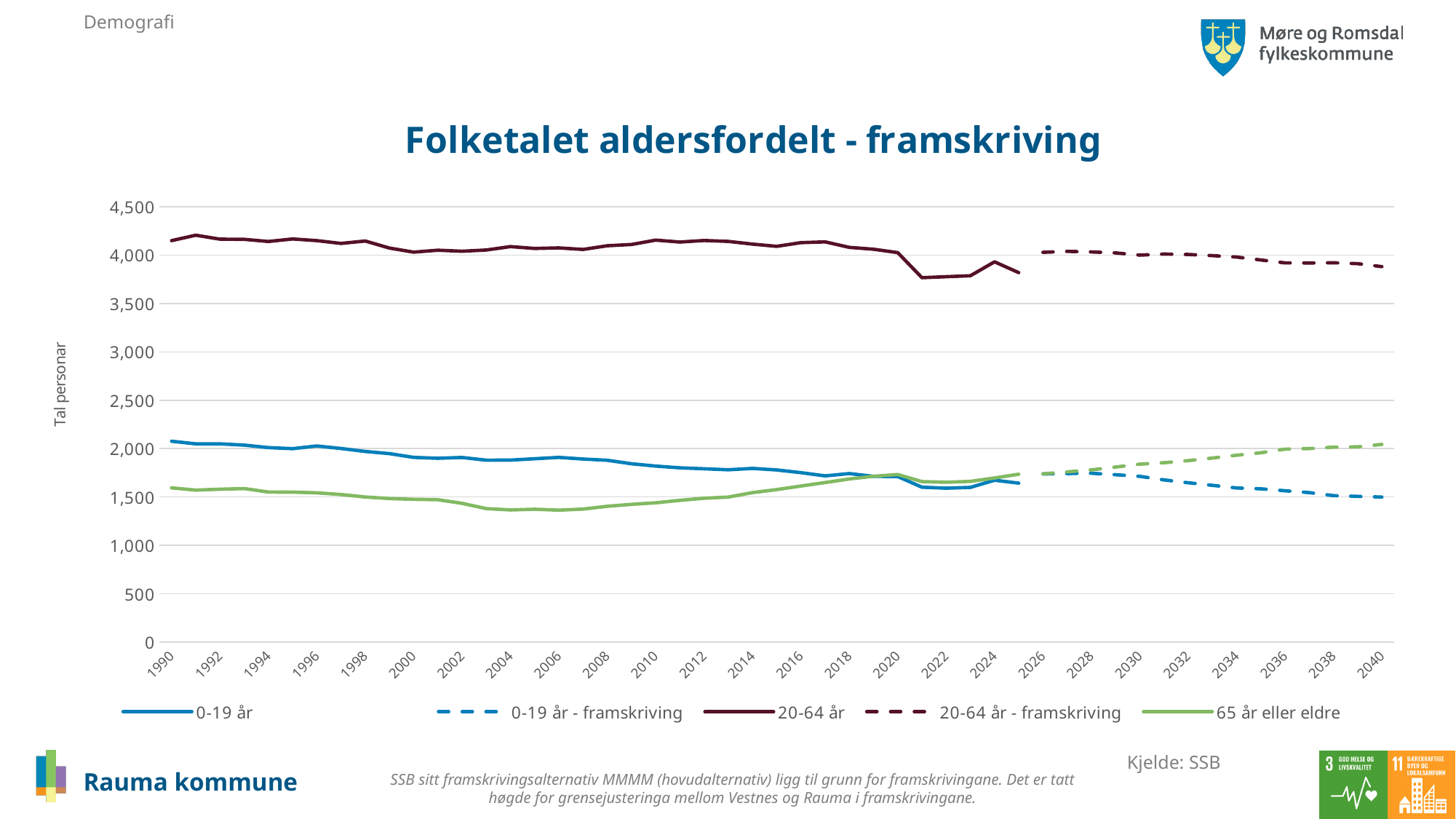
Is the value for 65 år eller eldre in 2004 greater or less than 1,500? less Is the value for 20-64 år - framskriving in 2040 greater or less than 4,000? less Is the value for 0-19 år in 2022 greater or less than 2,000? less Does the 0-19 år series rise or fall from 1990 to 2024? fall Which series has the highest values across the whole chart? 20-64 år How many series does the chart legend list? 5 What is the label on the vertical axis of the chart? Tal personar What is the title of the chart? Folketalet aldersfordelt - framskriving What kind of chart is shown on the slide? line chart In 1990, which is larger: the value for 0-19 år or the value for 65 år eller eldre? 0-19 år